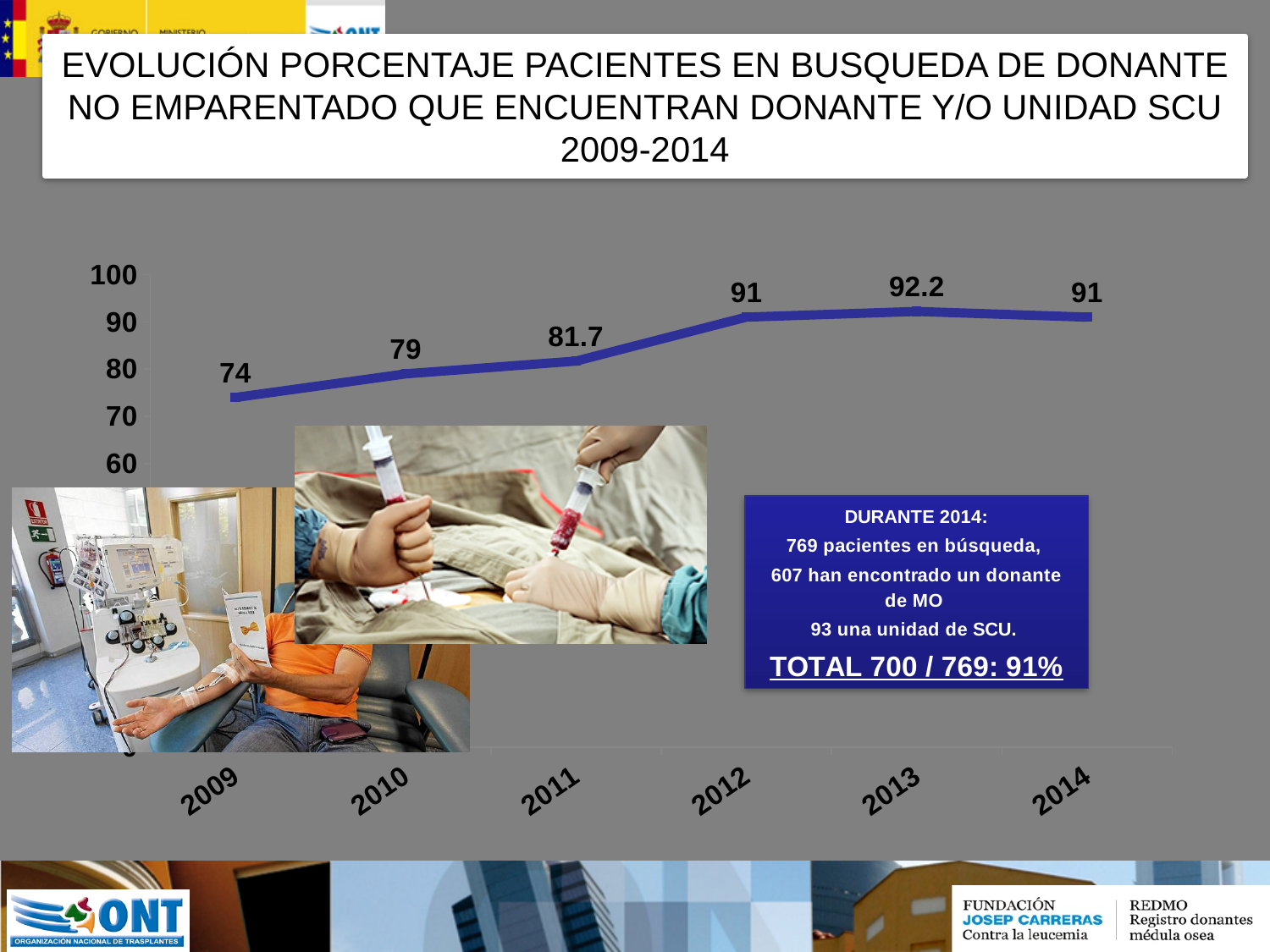
What is the value for 2013? 92.2 How many years are plotted on the chart? 6 What kind of chart is shown on the slide? line chart What is the difference between the values for 2012 and 2010? 12 Which year has the lowest value? 2009 Do the values generally rise or fall from 2009 to 2013? rise What is the value for 2011? 81.7 What is the value for 2009? 74 Which is larger, the value for 2010 or the value for 2011? 2011 Which year has the highest value? 2013 What is the value for 2014? 91 What is the difference between the values for 2014 and 2009? 17